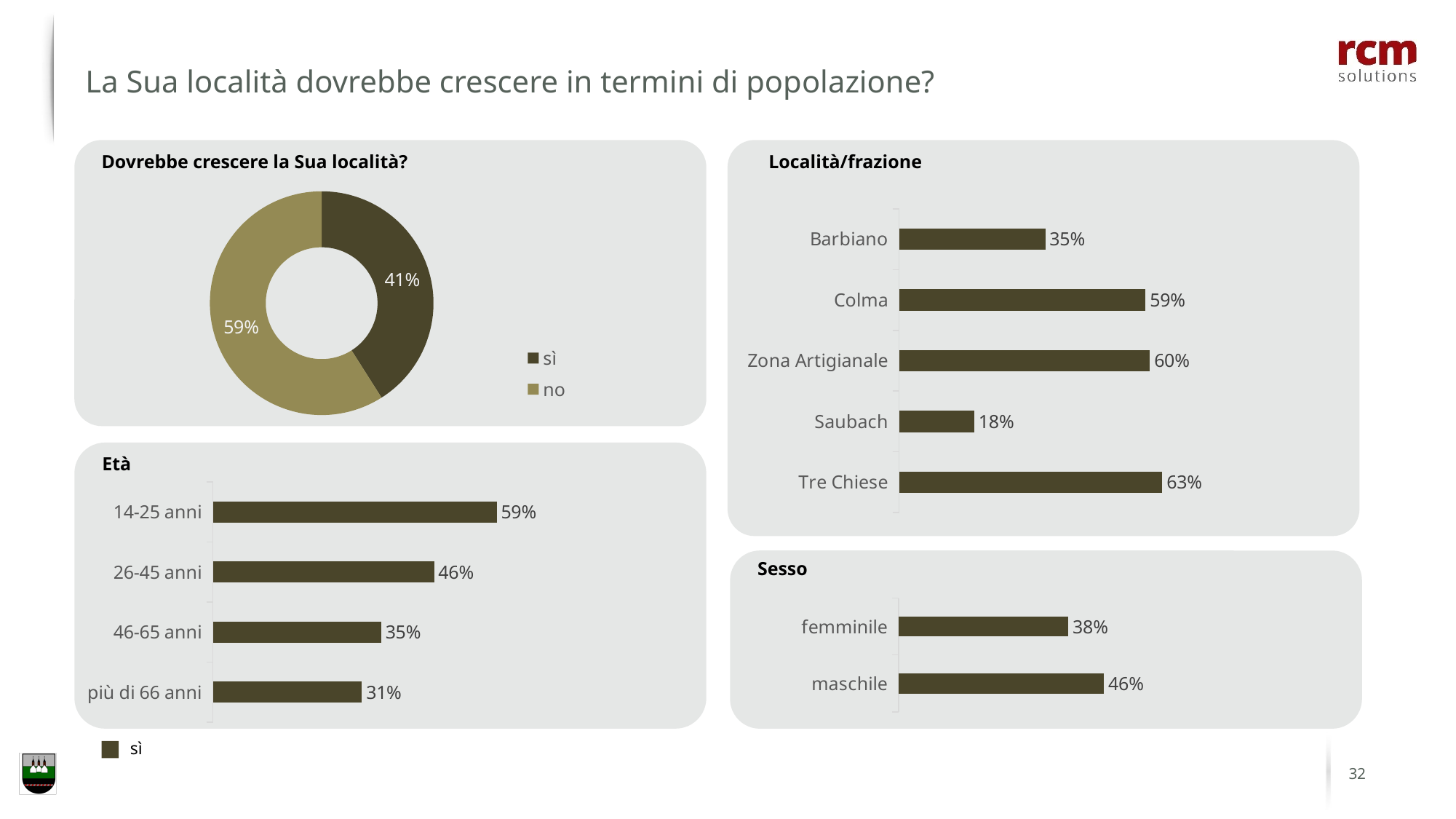
What kind of chart is the 'Dovrebbe crescere la Sua località?' chart? Doughnut chart In the 'Località/frazione' chart, which category has the lowest value? Saubach In the 'Dovrebbe crescere la Sua località?' chart, what percentage answered 'sì'? 41% In the 'Dovrebbe crescere la Sua località?' chart, what percentage answered 'no'? 59% How many categories are shown in the 'Località/frazione' chart? 5 In the 'Sesso' chart, what is the difference between maschile and femminile? 8 percentage points In the 'Età' chart, what is the value for 26-45 anni? 46% In the 'Località/frazione' chart, what is the difference between Tre Chiese and Barbiano? 28 percentage points In the 'Località/frazione' chart, which category has the highest value? Tre Chiese In the 'Età' chart, do the values rise or fall from the youngest to the oldest age group? Fall In the 'Località/frazione' chart, what is the value for Saubach? 18% In the 'Sesso' chart, which is larger, femminile or maschile? maschile